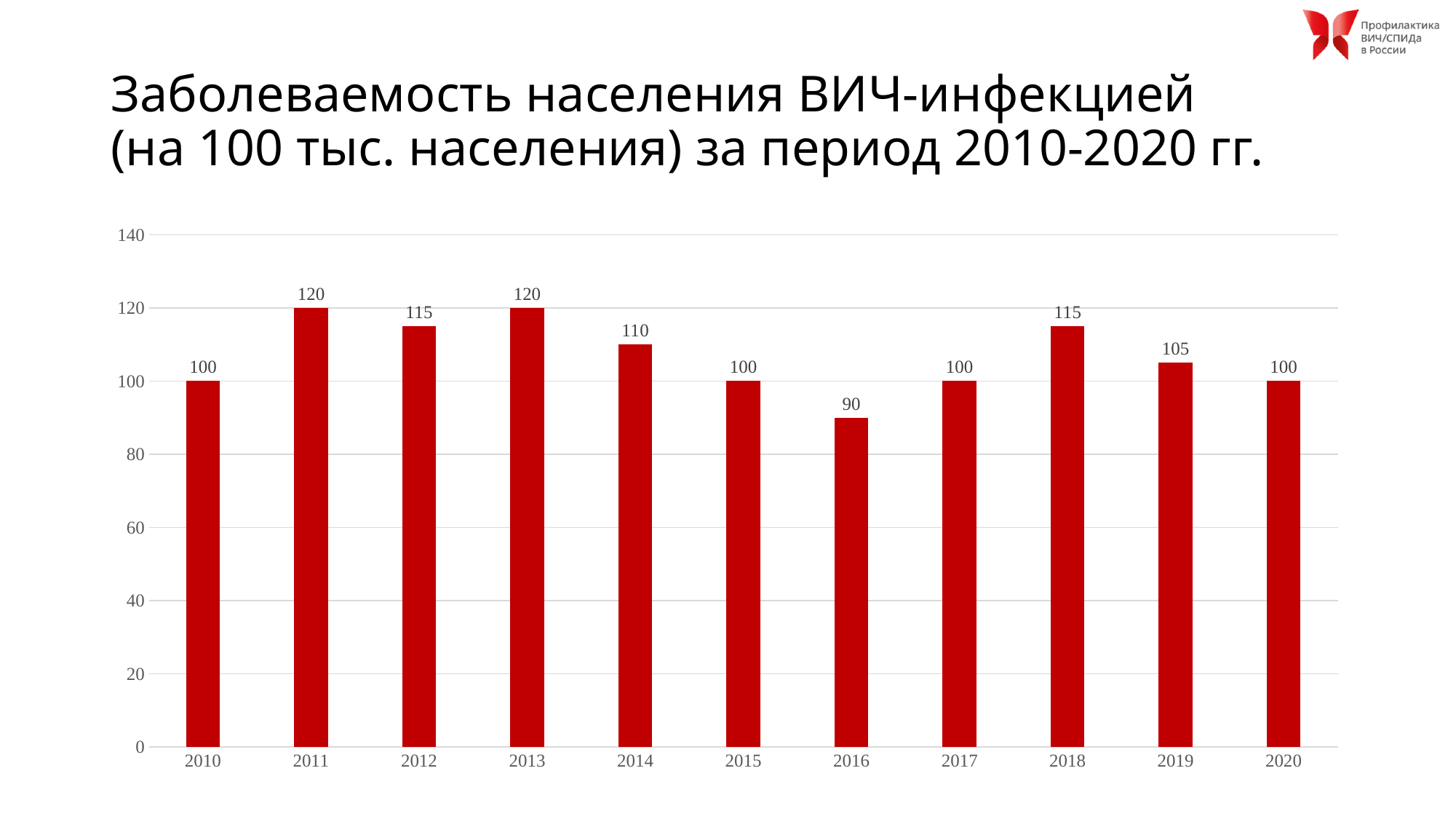
Do the values rise or fall from 2016 to 2018? rise What is the difference between the values for 2011 and 2016? 30 How many years are shown on the x axis? 11 What is the difference between the values for 2018 and 2019? 10 What is the value for 2014? 110 What kind of chart is shown on the slide? bar chart Which year has the lowest value? 2016 What is the value for 2016? 90 What is the value for 2019? 105 What colour are the bars in the chart? red Which is larger, the value for 2012 or the value for 2014? 2012 Is the value for 2016 greater or less than 100? less